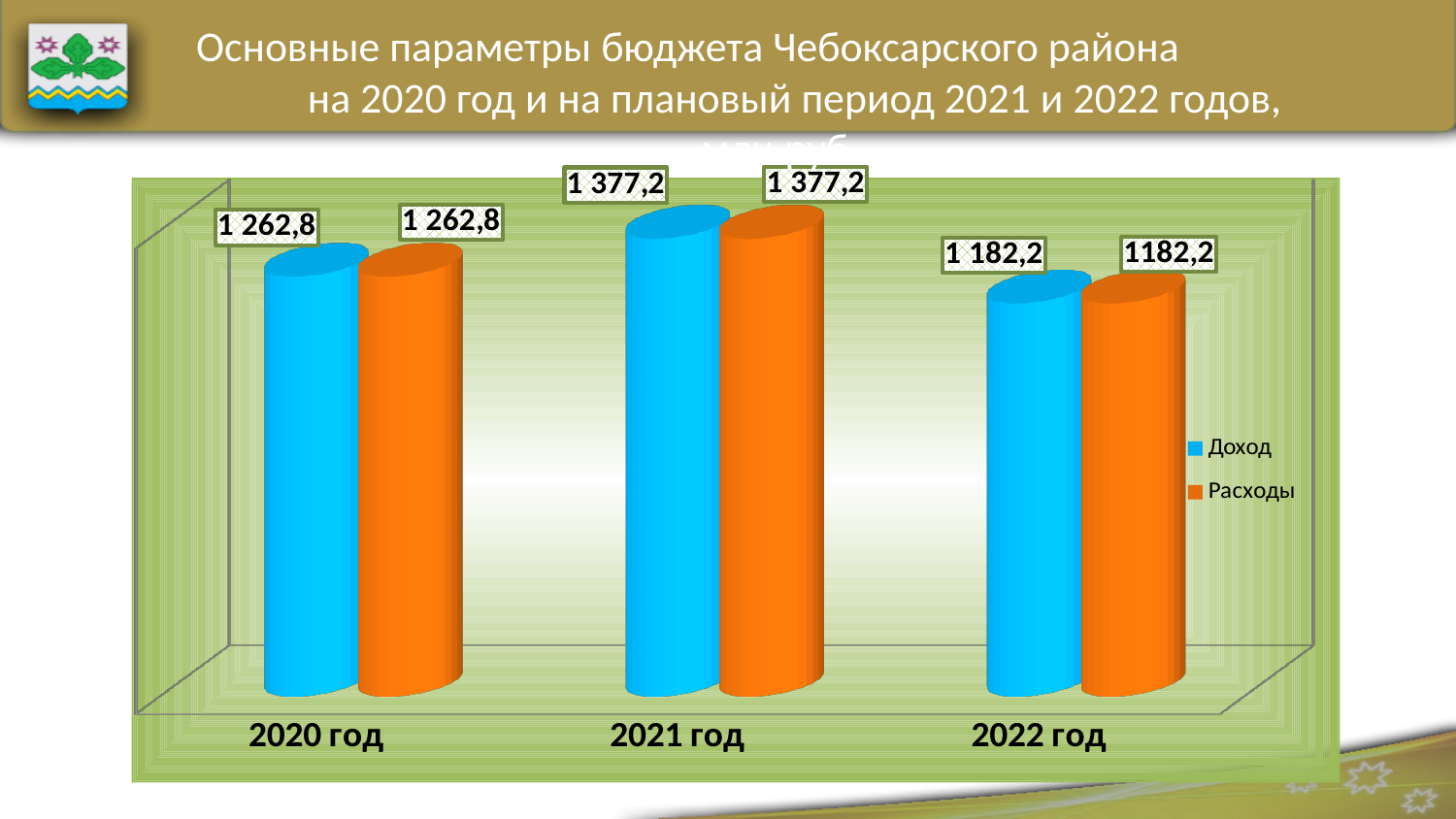
What is the value of Расходы for 2022 год? 1182,2 What is the difference between the Доход values for 2021 год and 2020 год? 114,4 What is the value of Доход for 2022 год? 1 182,2 What is the value of Доход for 2021 год? 1 377,2 Which is larger, the Доход value for 2020 год or for 2022 год? 2020 год How many year categories are shown on the x axis? 3 Which year has the lowest Расходы value? 2022 год Which year has the highest Доход value? 2021 год How many series does the legend list? 2 What is the difference between the Расходы values for 2020 год and 2022 год? 80,6 What is the value of Расходы for 2020 год? 1 262,8 What kind of chart is shown on the slide? Bar chart